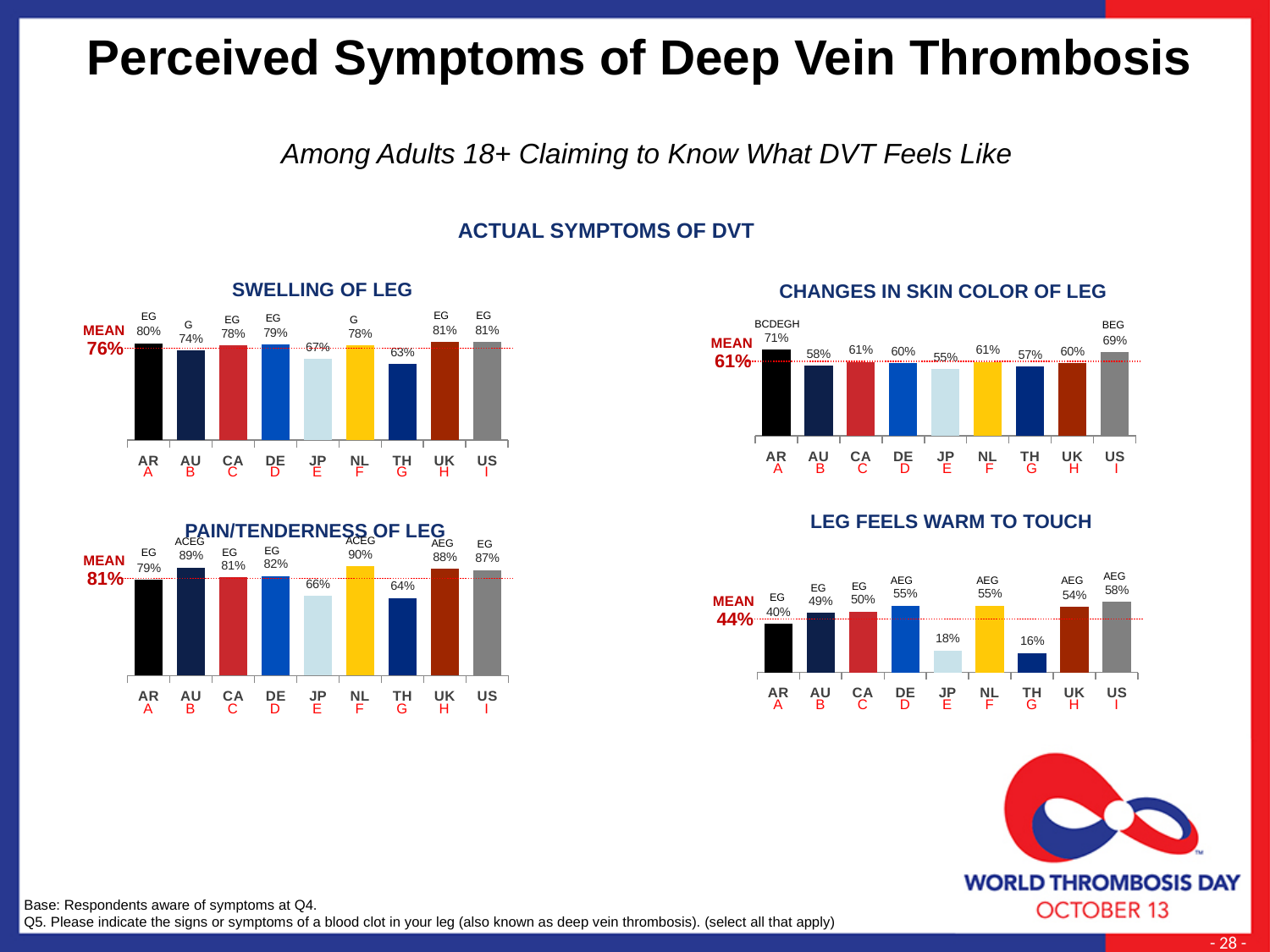
How many countries are shown in the "Leg Feels Warm to Touch" chart? 9 In the "Changes in Skin Color of Leg" chart, which country has the highest value? AR In the "Swelling of Leg" chart, which country has the lowest value? TH In the "Leg Feels Warm to Touch" chart, what is the difference between US and JP? 40% In the "Leg Feels Warm to Touch" chart, what is the value for TH? 16% In the "Changes in Skin Color of Leg" chart, what is the value for JP? 55% In the "Pain/Tenderness of Leg" chart, what is the mean value shown? 81% In the "Swelling of Leg" chart, what is the value for JP? 67% In the "Pain/Tenderness of Leg" chart, which is larger, the value for AU or the value for CA? AU In the "Changes in Skin Color of Leg" chart, what is the difference between AR and US? 2% What type of chart is the "Swelling of Leg" chart? Bar chart In the "Pain/Tenderness of Leg" chart, which country has the highest value? NL